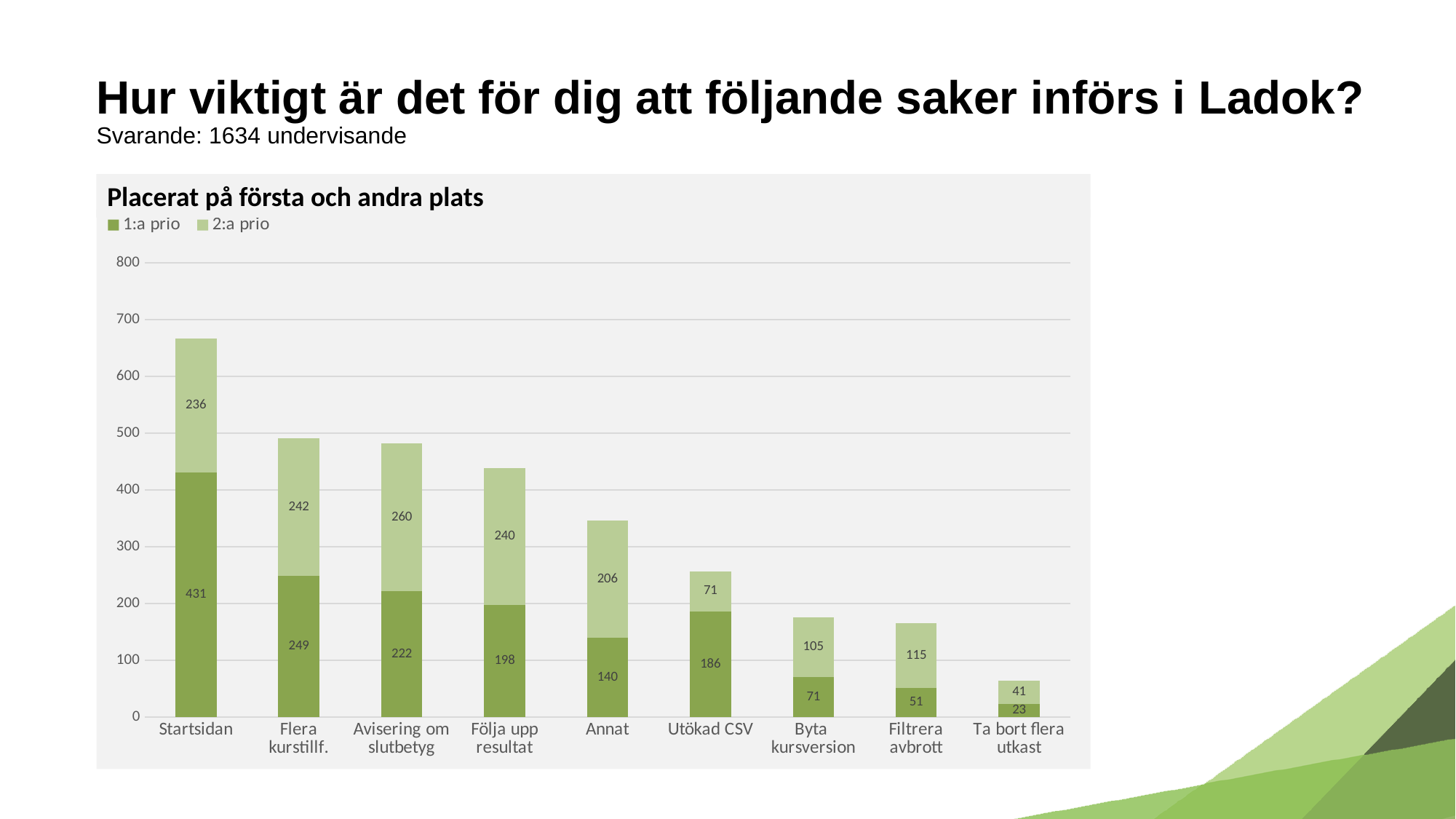
Which category has the highest 1:a prio value? Startsidan What kind of chart is shown on the slide? Stacked bar chart Which is larger for Annat: the 1:a prio value or the 2:a prio value? 2:a prio What is the total of the stacked bar for Byta kursversion? 176 How many series does the legend list? 2 What is the 1:a prio value for Startsidan? 431 Which category has the lowest 2:a prio value? Ta bort flera utkast How many categories are shown on the x axis? 9 What is the total of the stacked bar for Flera kurstillf.? 491 What is the difference between the 1:a prio and 2:a prio values for Startsidan? 195 What is the 1:a prio value for Utökad CSV? 186 What is the 2:a prio value for Avisering om slutbetyg? 260